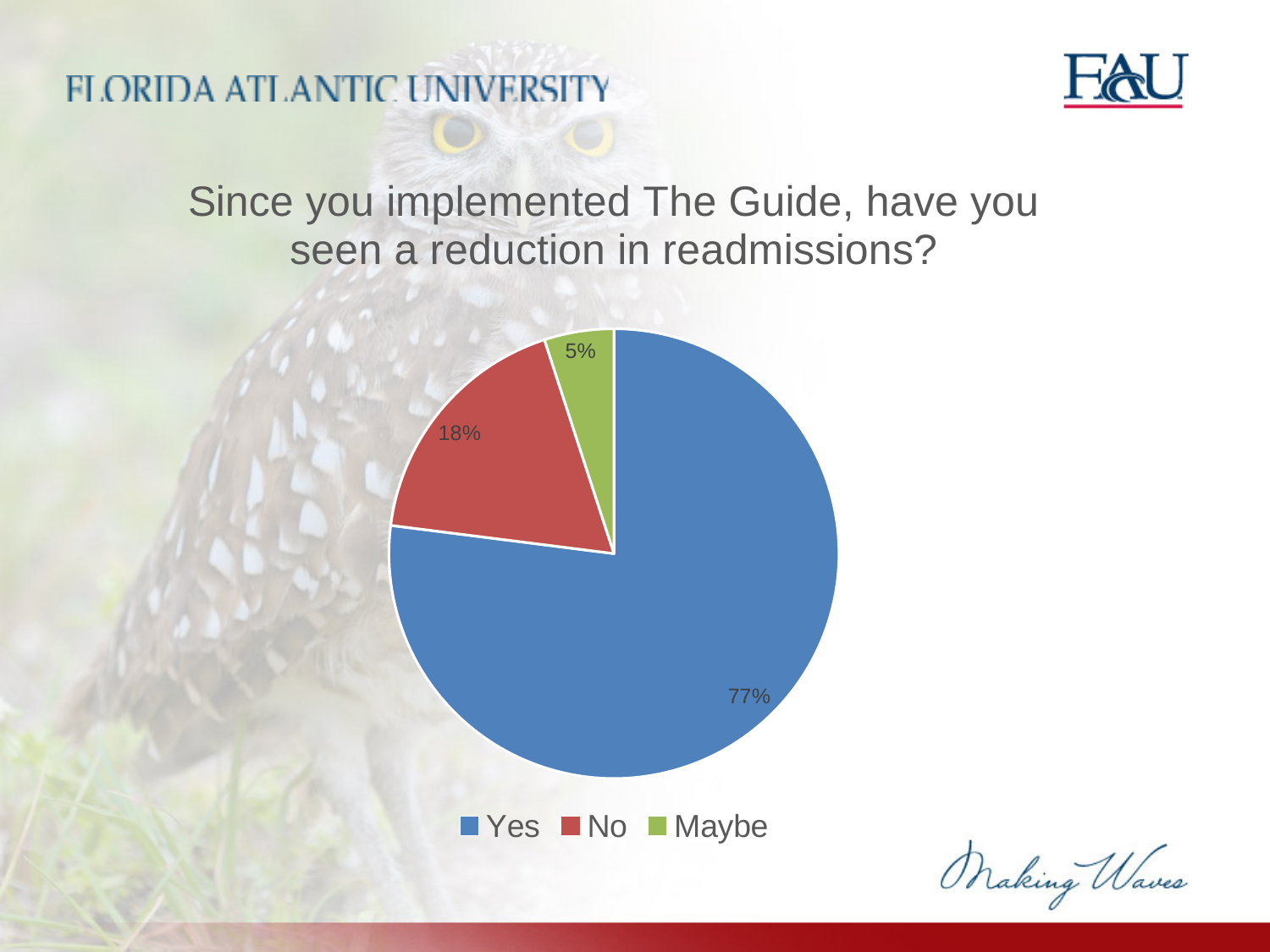
Which response has the largest share of the pie? Yes Which slice is larger, No or Maybe? No Which response has the smallest share of the pie? Maybe What kind of chart is shown on the slide? Pie chart What is the difference in percentage points between the No and Maybe slices? 13 What is the difference in percentage points between the Yes and No slices? 59 What colour is the Yes slice? Blue How many slices does the pie chart have? 3 What question does the chart title ask? Since you implemented The Guide, have you seen a reduction in readmissions? What percentage of respondents answered Yes? 77% What percentage of respondents answered Maybe? 5% What percentage of respondents answered No? 18%